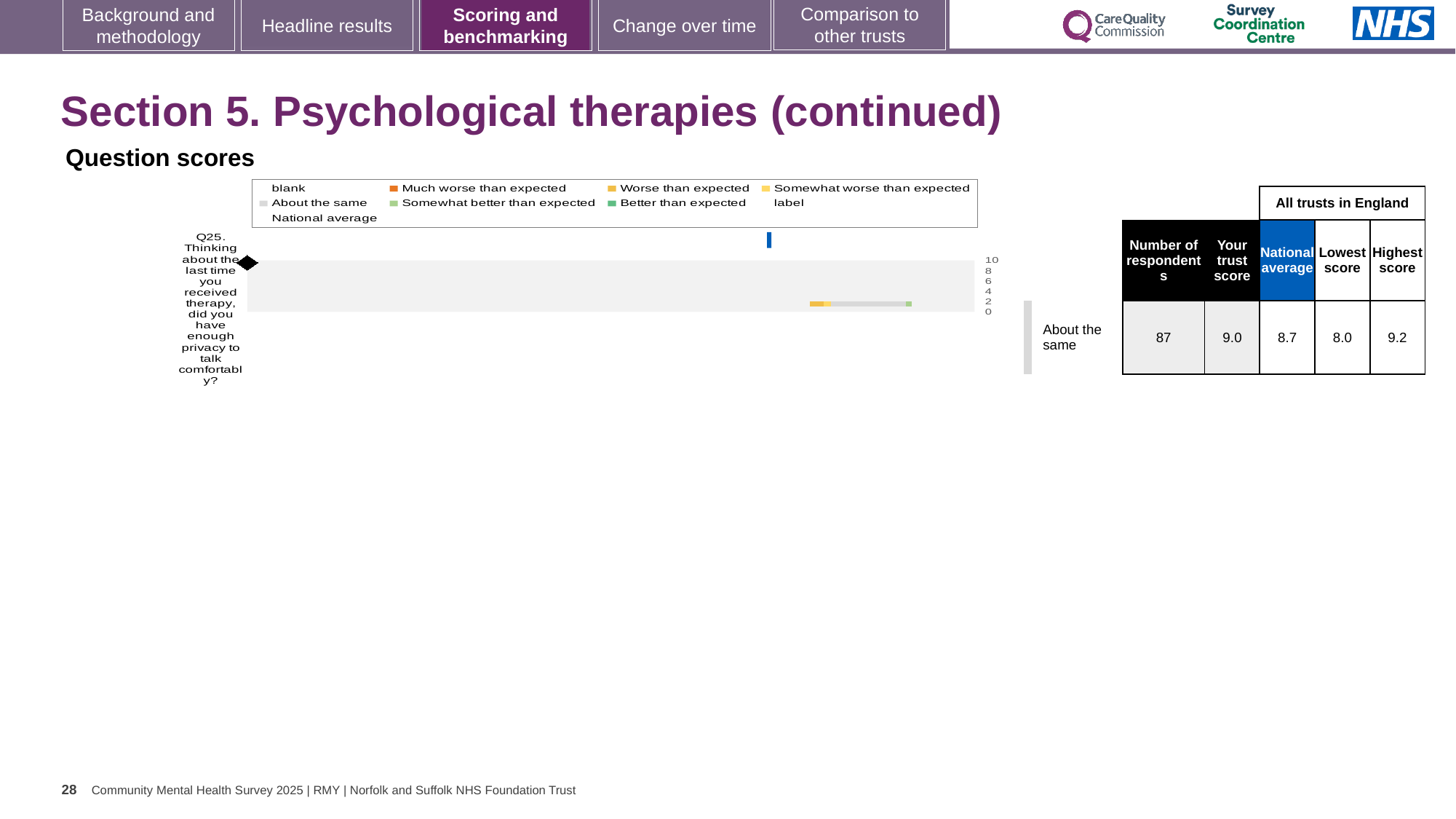
What is the lowest score among all trusts in England for Q25? 8.0 How many survey questions are plotted in the Question scores chart? 1 What is the national average score for Q25? 8.7 What is the highest value shown on the chart's score axis? 10 What is the difference between the highest score and the lowest score for Q25 across all trusts in England? 1.2 What kind of chart is shown under 'Question scores'? bar chart How many respondents answered Q25? 87 What benchmark category is the trust's Q25 score placed in? About the same For Q25, which is larger: the trust's score or the national average? the trust's score What is the highest score among all trusts in England for Q25? 9.2 What is the trust's score for Q25 (privacy to talk comfortably during therapy)? 9.0 Which question number is plotted in the Question scores chart? Q25